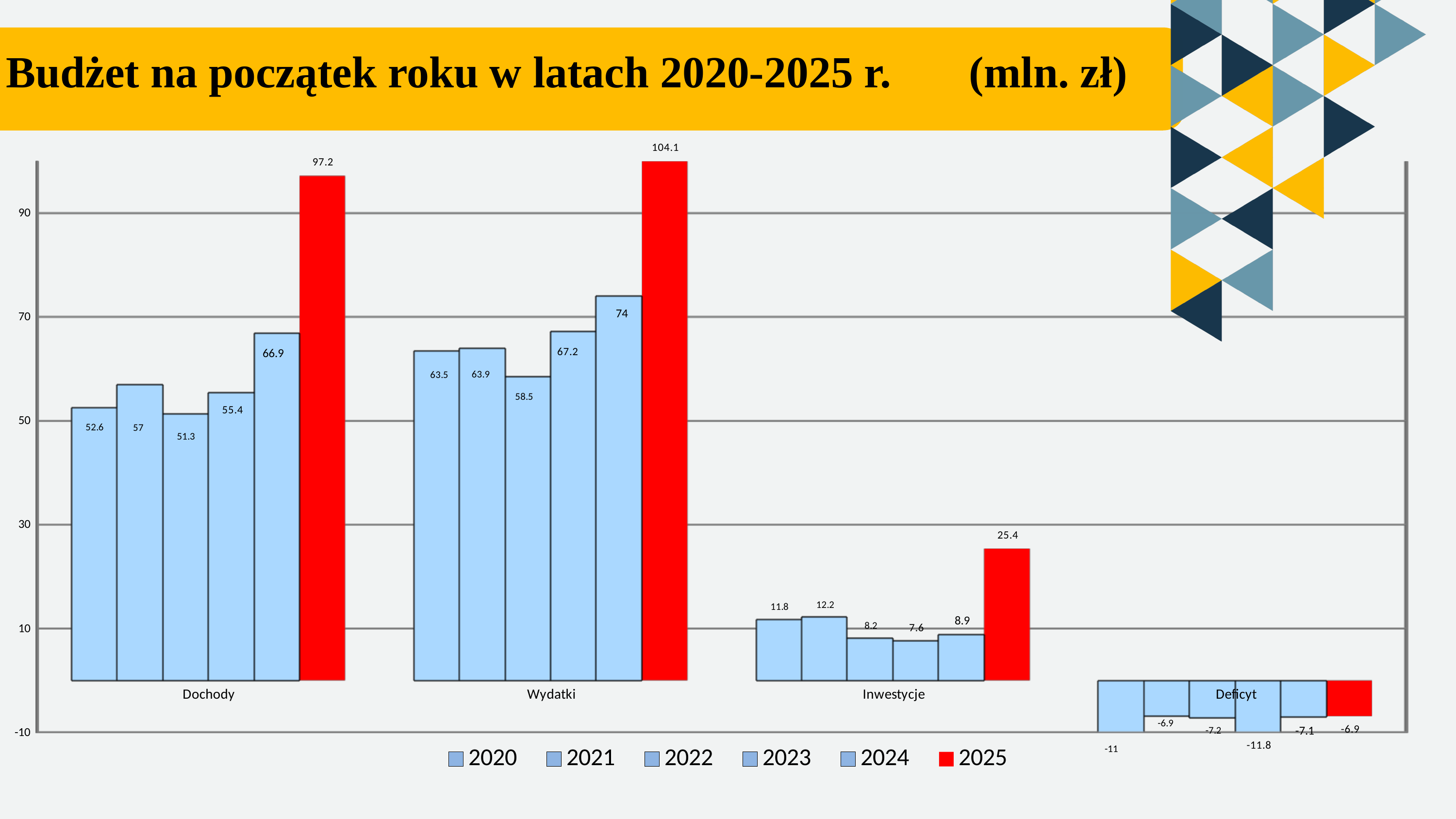
How many series does the legend list? 6 How many categories are shown on the x axis? 4 Which year has the lowest value for Dochody? 2022 What is the difference between Wydatki and Dochody in 2025? 6.9 What is the value for Wydatki in 2024? 74 What is the value for Inwestycje in 2023? 7.6 What kind of chart is shown on the slide? bar chart Which year has the highest value for Wydatki? 2025 What is the value for Deficyt in 2020? -11 Which is larger, Inwestycje in 2020 or Inwestycje in 2021? 2021 What is the value for Dochody in 2025? 97.2 Which series is shown in red? 2025